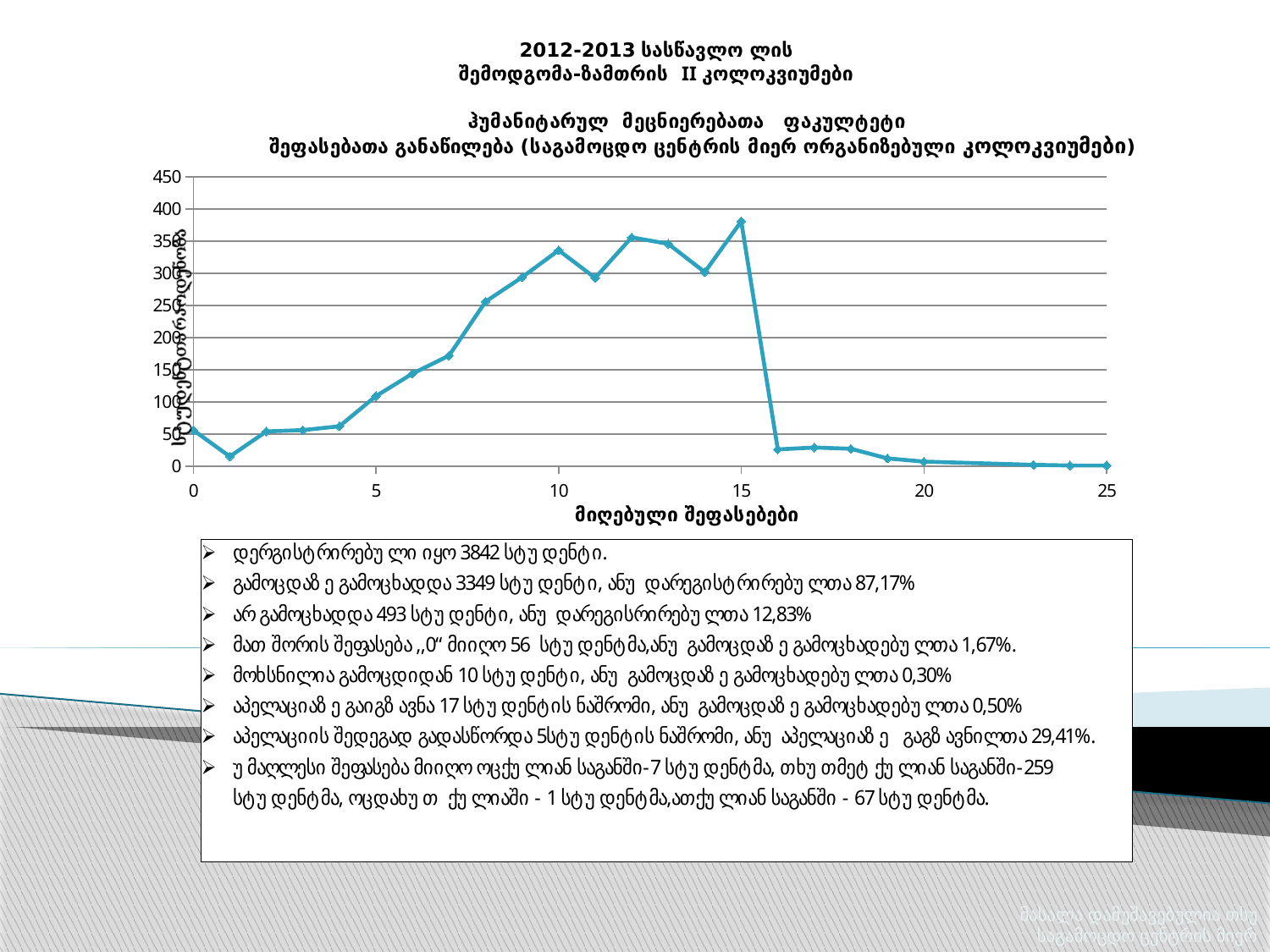
Do the values rise or fall between x = 15 and x = 25? fall Which has the larger value, x = 15 or x = 16? x = 15 Which has the larger value, x = 10 or x = 11? x = 10 Is the value at x = 1 greater or less than 50? less Is the value at x = 16 greater or less than 50? less What is the title of the x axis? მიღებული შეფასებები Is the value at x = 15 greater or less than 350? greater Do the values rise or fall between x = 4 and x = 10? rise What kind of chart is shown on the slide? line chart At which x-axis value does the line reach its highest point? 15